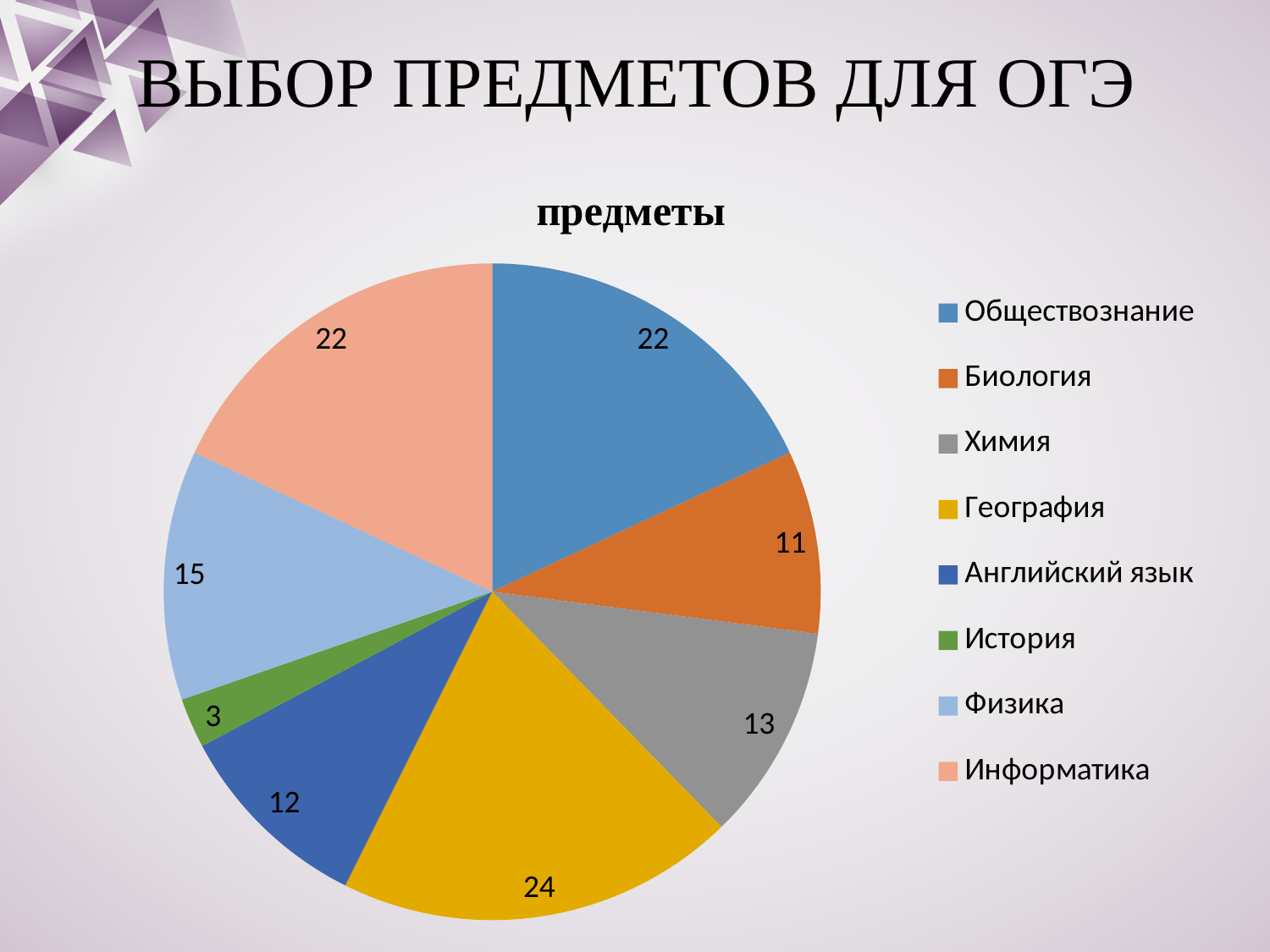
Which subject has the smallest slice in the pie chart? История How many slices does the pie chart have? 8 What is the difference between the values for География and Биология? 13 What is the difference between the values for Физика and История? 12 What is the value for Физика in the pie chart? 15 What is the value for История in the pie chart? 3 What is the value for География in the pie chart? 24 Which is larger, the value for Физика or the value for Английский язык? Физика What is the title of the chart? предметы What is the value for Химия in the pie chart? 13 Which subject has the largest slice in the pie chart? География What type of chart is shown on the slide? Pie chart